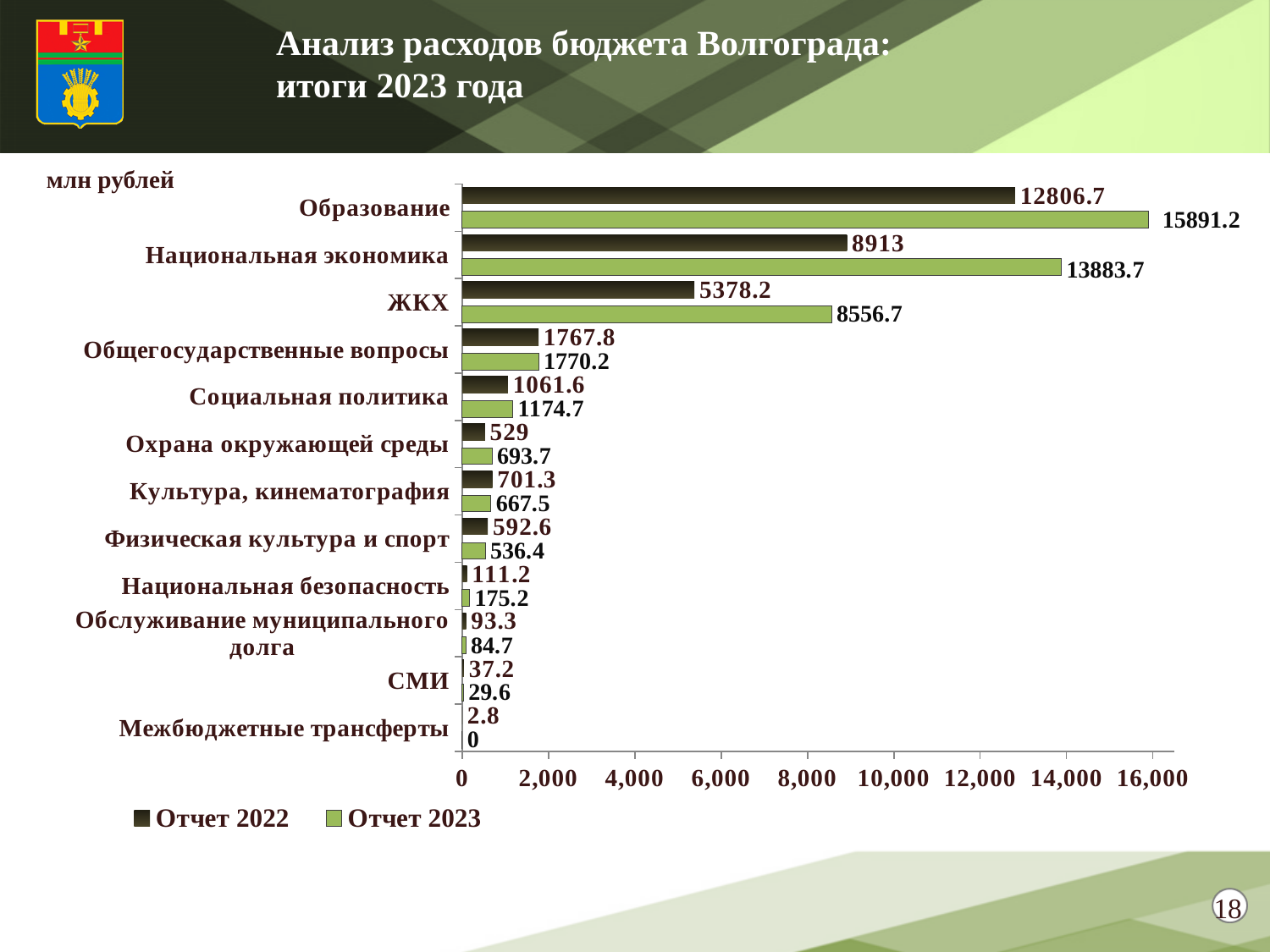
What is the value for Образование in the Отчет 2023 series? 15891.2 How many categories are shown on the chart? 12 What kind of chart is shown on the slide? bar chart What is the value for Социальная политика in the Отчет 2022 series? 1061.6 Is the Отчет 2022 value for Национальная экономика greater or less than 8,000? greater How many series does the legend list? 2 Which category has the highest value in the Отчет 2023 series? Образование What is the difference between the Отчет 2023 and Отчет 2022 values for Образование? 3084.5 For Культура, кинематография, which is larger: the Отчет 2022 value or the Отчет 2023 value? Отчет 2022 What is the value for Национальная экономика in the Отчет 2023 series? 13883.7 Which category has the lowest value in the Отчет 2023 series? Межбюджетные трансферты What is the value for ЖКХ in the Отчет 2022 series? 5378.2